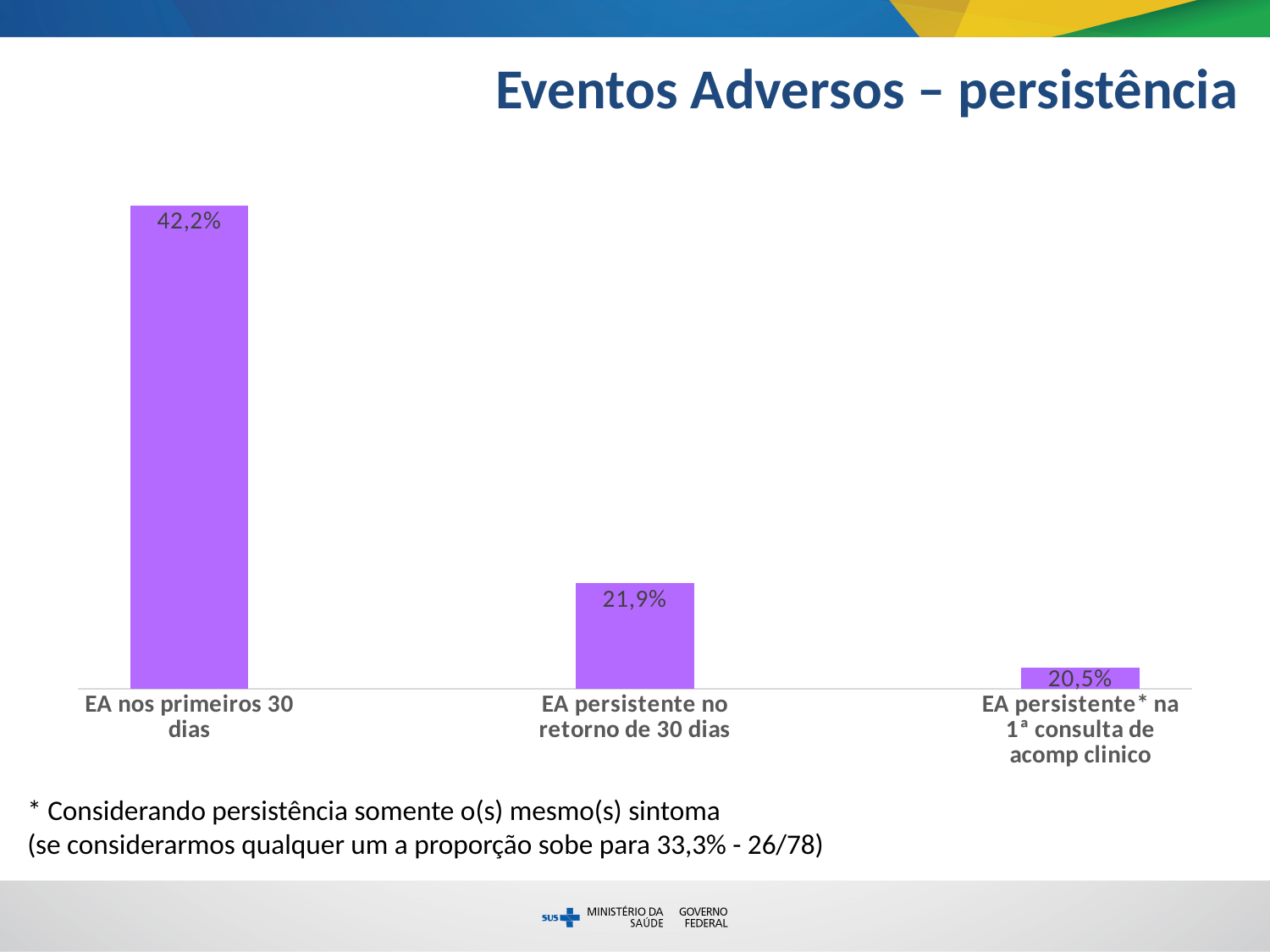
What is the difference between 'EA nos primeiros 30 dias' and 'EA persistente no retorno de 30 dias'? 20,3 percentage points What colour are the bars in the chart? Purple What is the value for 'EA persistente no retorno de 30 dias'? 21,9% What is the value for 'EA nos primeiros 30 dias'? 42,2% Which category has the lowest value? EA persistente* na 1ª consulta de acomp clinico Which is larger: 'EA persistente no retorno de 30 dias' or 'EA persistente* na 1ª consulta de acomp clinico'? EA persistente no retorno de 30 dias Which category has the highest value? EA nos primeiros 30 dias Do the values rise or fall from left to right along the x axis? Fall What is the value for 'EA persistente* na 1ª consulta de acomp clinico'? 20,5% What is the difference between 'EA persistente no retorno de 30 dias' and 'EA persistente* na 1ª consulta de acomp clinico'? 1,4 percentage points How many categories are shown in the chart? 3 What kind of chart is shown on the slide? Bar chart